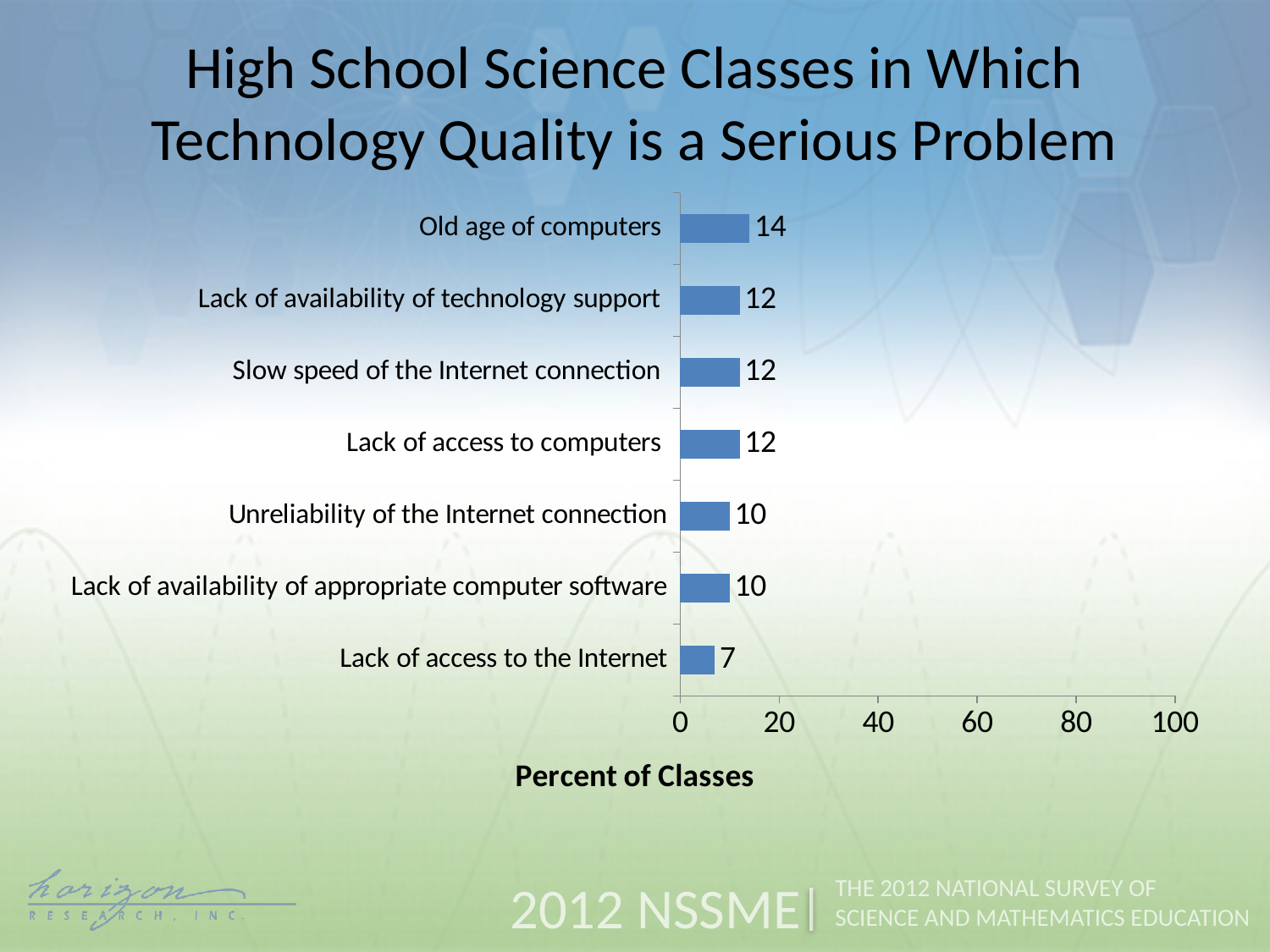
Is the value for old age of computers greater or less than 20? less Which category has the lowest value? Lack of access to the Internet What kind of chart is shown on the slide? Bar chart What is the value for slow speed of the Internet connection? 12 Which category has the highest value? Old age of computers What is the value for lack of access to the Internet? 7 What is the label of the horizontal axis? Percent of Classes What is the value for unreliability of the Internet connection? 10 What percent of classes report old age of computers as a serious problem? 14 Which is larger: the value for lack of access to computers or the value for lack of availability of appropriate computer software? Lack of access to computers How many categories are shown in the chart? 7 What is the difference between the values for old age of computers and lack of access to the Internet? 7